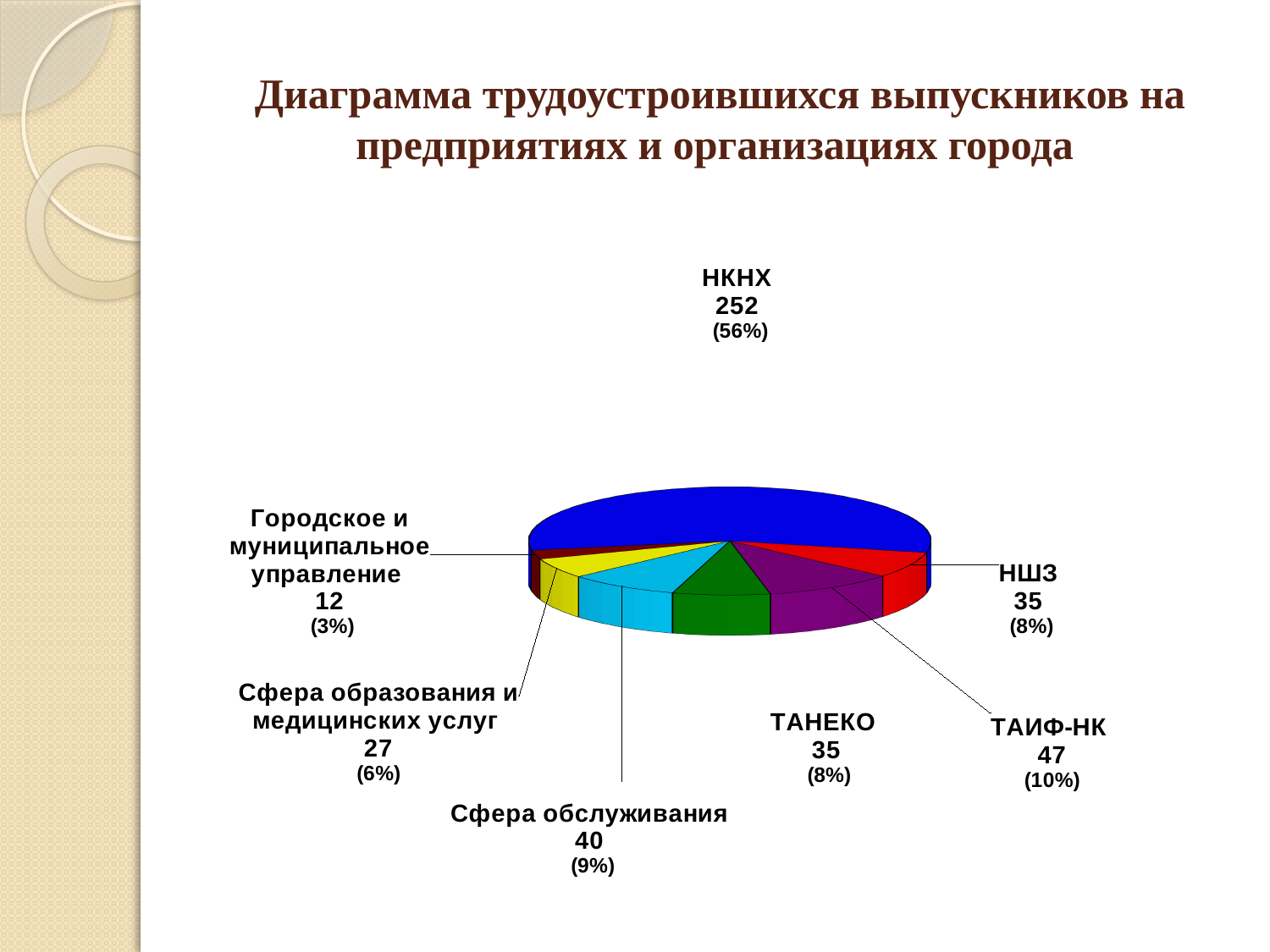
Which category has the largest slice of the pie? НКНХ How many graduates were employed at ТАИФ-НК? 47 What percentage is shown for Сфера обслуживания? 9% What is the value shown for Городское и муниципальное управление? 12 What type of chart is shown on the slide? pie chart How many categories (slices) does the pie chart have? 7 What is the difference between the values for НКНХ and ТАИФ-НК? 205 Which is larger, the value for Сфера обслуживания or the value for Сфера образования и медицинских услуг? Сфера обслуживания How many graduates were employed at НКНХ? 252 What share of the pie does НКНХ represent? 56% Which category has the smallest slice of the pie? Городское и муниципальное управление What is the title of the chart on the slide? Диаграмма трудоустроившихся выпускников на предприятиях и организациях города